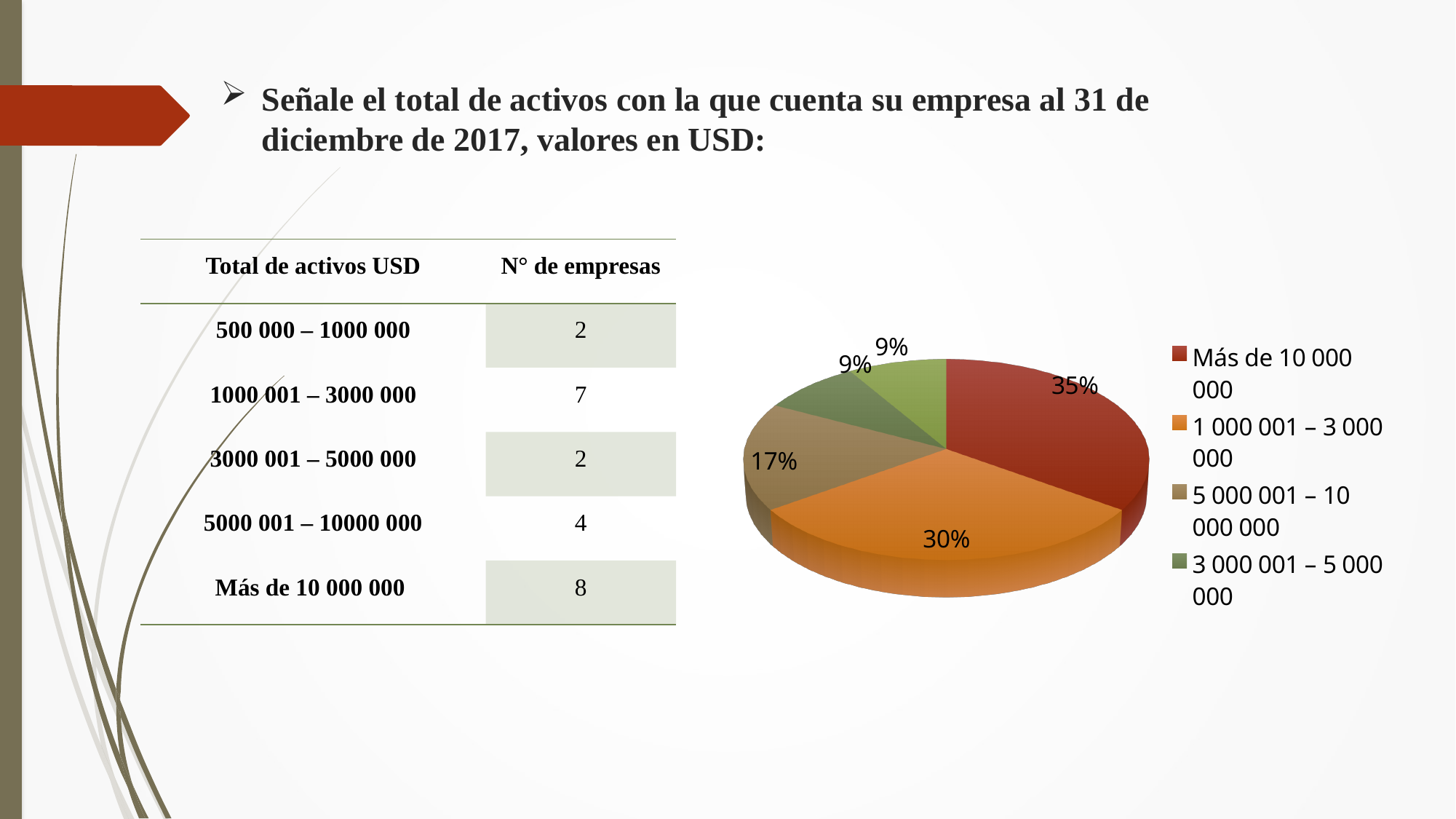
What is the difference in percentage points between the 'Más de 10 000 000' slice and the '1 000 001 – 3 000 000' slice? 5 Which slice is larger in the pie chart: '5 000 001 – 10 000 000' or '3 000 001 – 5 000 000'? 5 000 001 – 10 000 000 Which category has the largest slice in the pie chart? Más de 10 000 000 What percentage does the pie chart show for '3 000 001 – 5 000 000'? 9% What percentage does the pie chart show for '1 000 001 – 3 000 000'? 30% What kind of chart is shown on the slide? pie chart What percentage does the pie chart show for '5 000 001 – 10 000 000'? 17% How many slices does the pie chart have? 5 What colour is the largest slice of the pie chart? red How many entries does the pie chart's legend list? 4 What percentage does the pie chart show for 'Más de 10 000 000'? 35% What colour is the '1 000 001 – 3 000 000' slice in the pie chart? orange